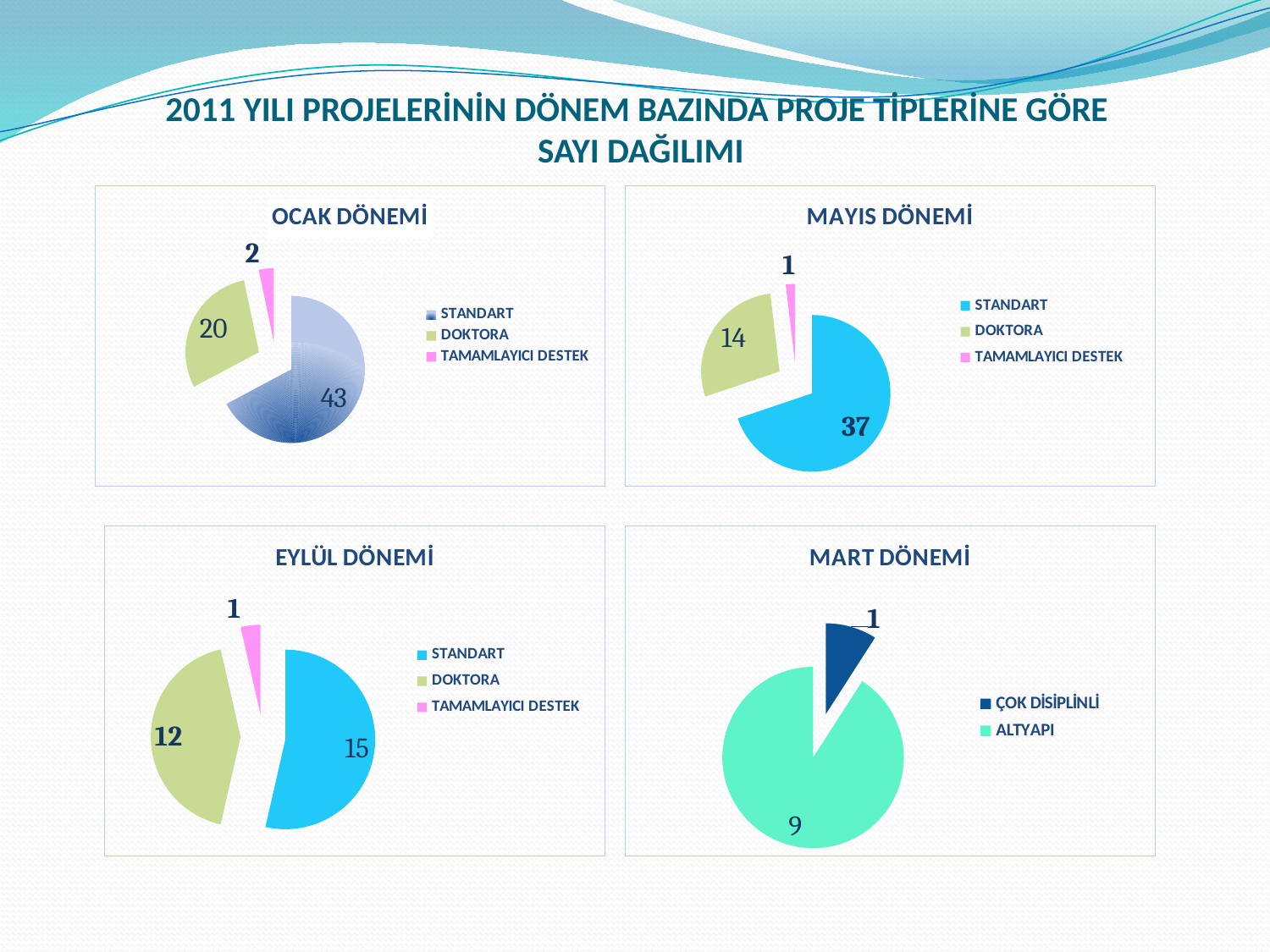
In the MART DÖNEMİ chart, which is larger, ÇOK DİSİPLİNLİ or ALTYAPI? ALTYAPI In the MAYIS DÖNEMİ chart, which category has the largest slice? STANDART In the OCAK DÖNEMİ chart, what is the value for DOKTORA? 20 In the EYLÜL DÖNEMİ chart, what is the difference between STANDART and DOKTORA? 3 In the EYLÜL DÖNEMİ chart, which category has the smallest slice? TAMAMLAYICI DESTEK In the OCAK DÖNEMİ chart, what is the value for STANDART? 43 In the MAYIS DÖNEMİ chart, what is the value for TAMAMLAYICI DESTEK? 1 How many entries does the legend of the OCAK DÖNEMİ chart list? 3 In the MAYIS DÖNEMİ chart, what is the difference between STANDART and DOKTORA? 23 What kind of chart is the EYLÜL DÖNEMİ chart? Pie chart How many categories does the MART DÖNEMİ chart show? 2